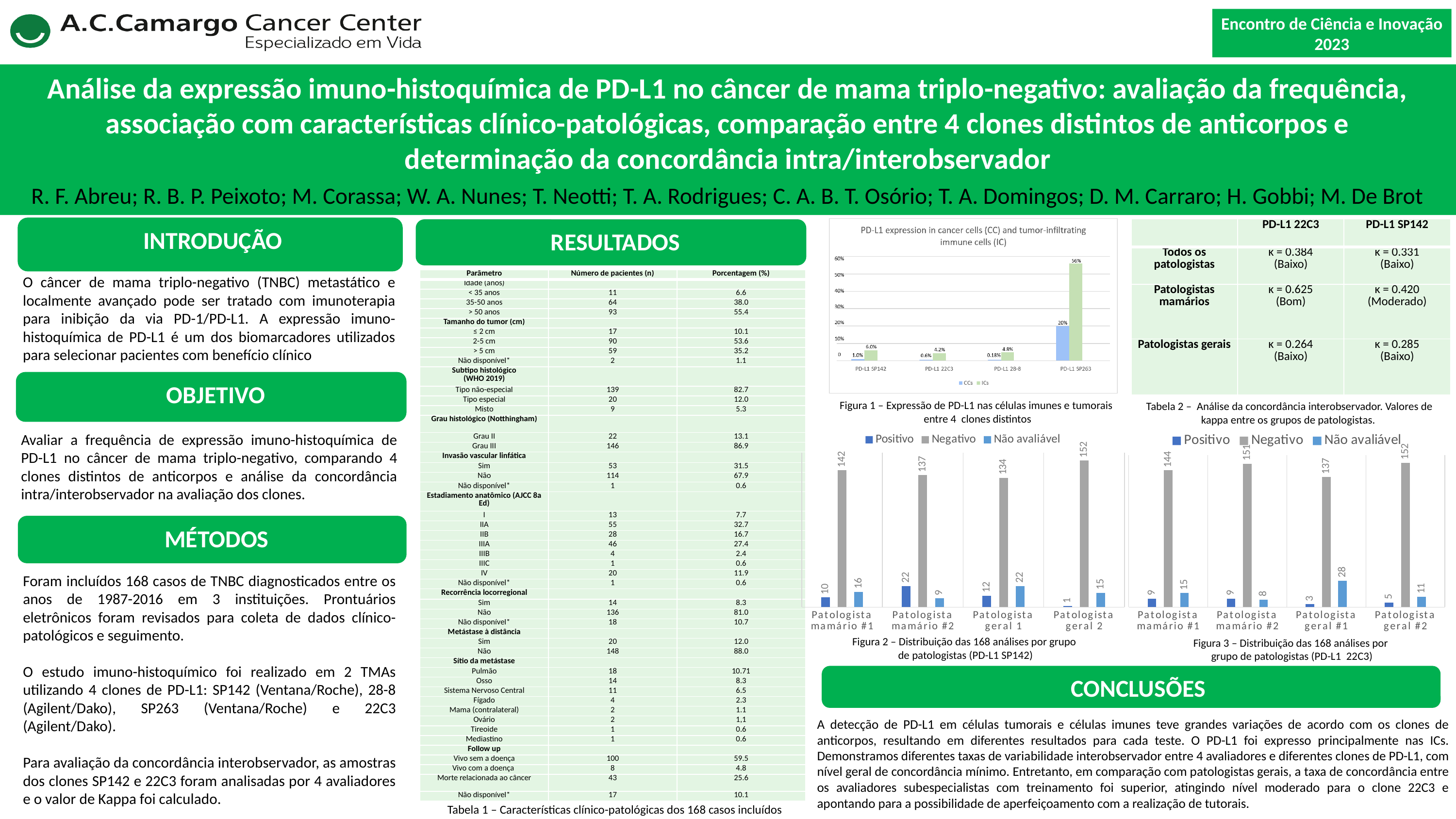
In Figura 1 (PD-L1 expression in cancer cells and tumor-infiltrating immune cells), what is the CC value for PD-L1 SP142? 1.0% In Figura 3 (Distribuição das 168 análises por grupo de patologistas, PD-L1 22C3), which pathologist has the highest Negativo value? Patologista geral #2 In Figura 3 (Distribuição das 168 análises por grupo de patologistas, PD-L1 22C3), which is larger: the Positivo value for Patologista geral #1 or for Patologista geral #2? Patologista geral #2 In Figura 2 (Distribuição das 168 análises por grupo de patologistas, PD-L1 SP142), how many pathologist categories are shown on the x axis? 4 In Figura 2 (Distribuição das 168 análises por grupo de patologistas, PD-L1 SP142), what is the difference between the Negativo values of Patologista geral 2 and Patologista geral 1? 18 What type of chart is Figura 3 (Distribuição das 168 análises por grupo de patologistas, PD-L1 22C3)? Bar chart In Figura 2 (Distribuição das 168 análises por grupo de patologistas, PD-L1 SP142), what is the Negativo value for Patologista mamário #2? 137 In Figura 1 (PD-L1 expression in cancer cells and tumor-infiltrating immune cells), what is the IC value for PD-L1 SP263? 56% In Figura 1 (PD-L1 expression in cancer cells and tumor-infiltrating immune cells), which clone has the highest IC value? PD-L1 SP263 In Figura 3 (Distribuição das 168 análises por grupo de patologistas, PD-L1 22C3), what is the Não avaliável value for Patologista geral #1? 28 In Figura 1 (PD-L1 expression in cancer cells and tumor-infiltrating immune cells), how many series does the legend list? 2 In Figura 2 (Distribuição das 168 análises por grupo de patologistas, PD-L1 SP142), which pathologist has the lowest Positivo value? Patologista geral 2